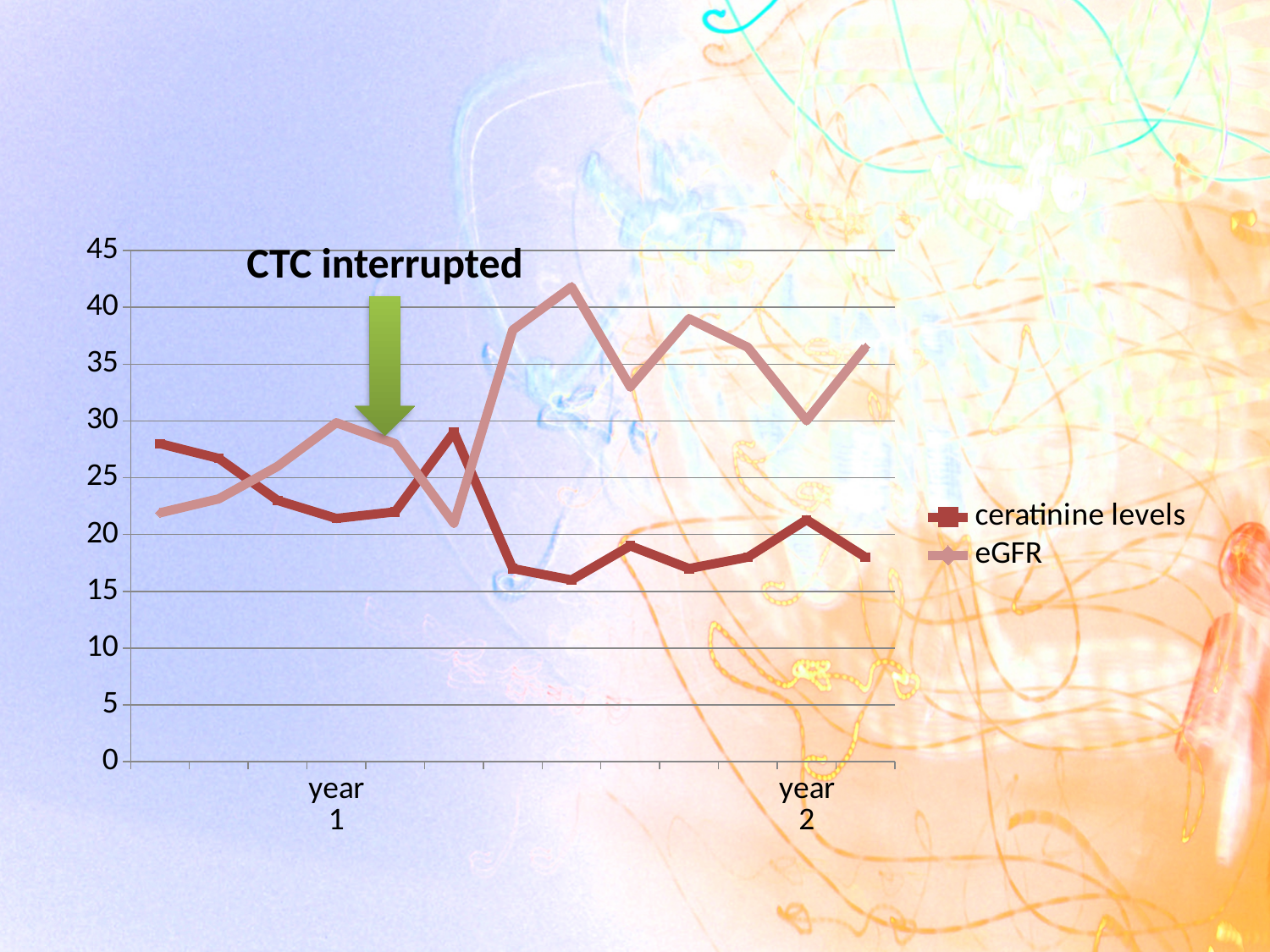
How many series does the legend list? 2 Is the value for ceratinine levels at year 2 greater or less than 25? less Is the value for eGFR at year 2 greater or less than 35? less At year 2, which series has the larger value, ceratinine levels or eGFR? eGFR Overall, do the ceratinine levels rise or fall from the left end of the chart to the right end? fall Which series reaches the highest value anywhere on the chart? eGFR How many labeled categories are shown on the x axis? 2 What are the two series named in the legend? ceratinine levels and eGFR What text does the annotation above the green arrow say? CTC interrupted What kind of chart is shown on the slide? line chart Is the value for ceratinine levels at year 1 greater or less than 25? less